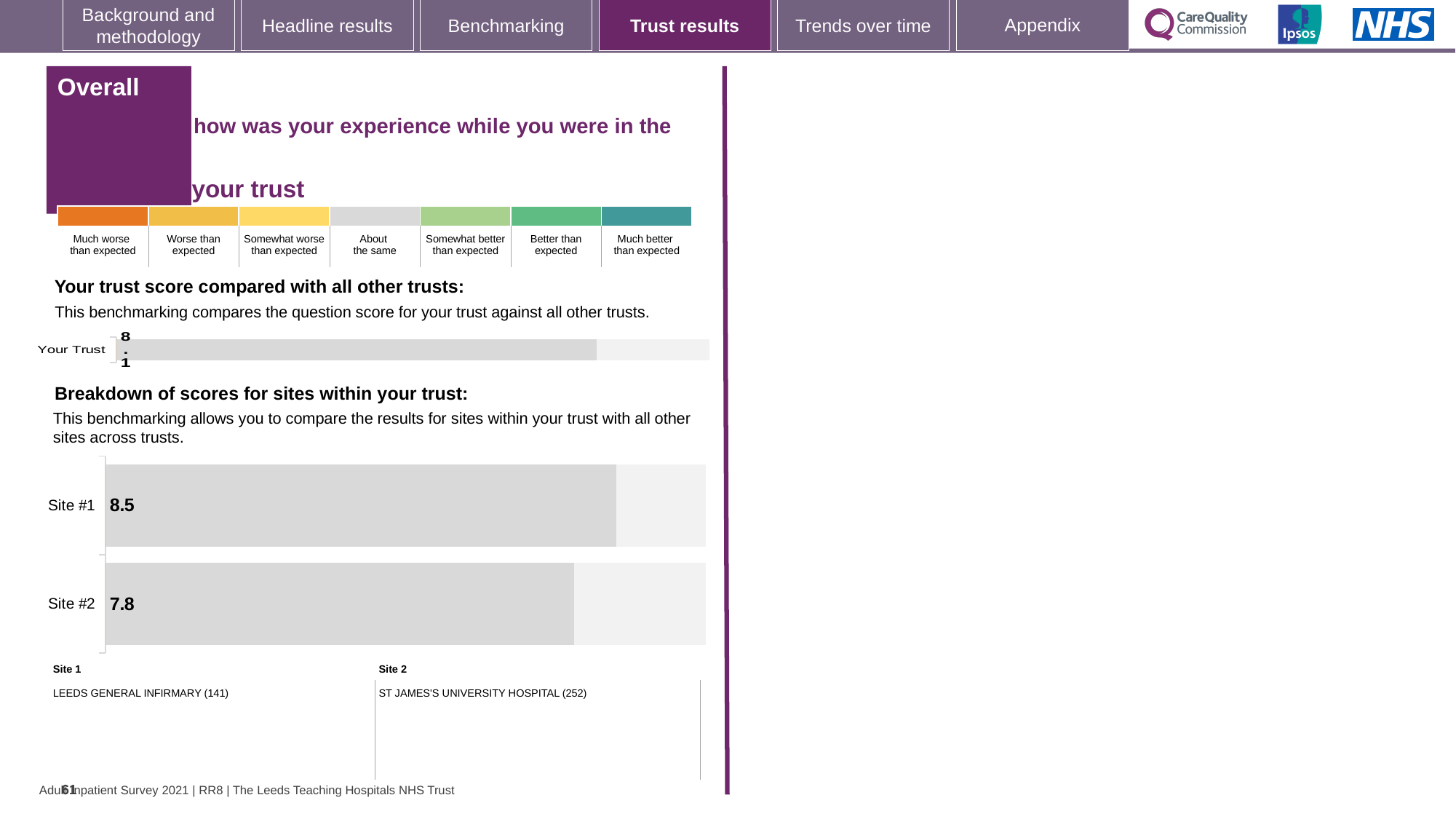
How many bars are shown in the 'Your trust score compared with all other trusts' chart? 1 According to the key below the site chart, which hospital is Site 1? LEEDS GENERAL INFIRMARY (141) What kind of chart is the 'Breakdown of scores for sites within your trust' chart? Bar chart In the 'Breakdown of scores for sites within your trust' chart, which site has the highest score? Site #1 How many sites are plotted in the 'Breakdown of scores for sites within your trust' chart? 2 In the 'Your trust score compared with all other trusts' chart, what is the score shown for Your Trust? 8.1 In the 'Breakdown of scores for sites within your trust' chart, which has the larger score, Site #1 or Site #2? Site #1 Is the Site #1 score in the 'Breakdown of scores for sites within your trust' chart greater or less than the Your Trust score of 8.1? greater In the 'Breakdown of scores for sites within your trust' chart, what is the score for Site #2? 7.8 In the 'Breakdown of scores for sites within your trust' chart, which site has the lowest score? Site #2 In the 'Breakdown of scores for sites within your trust' chart, what is the score for Site #1? 8.5 In the 'Breakdown of scores for sites within your trust' chart, what is the difference between the scores of Site #1 and Site #2? 0.7